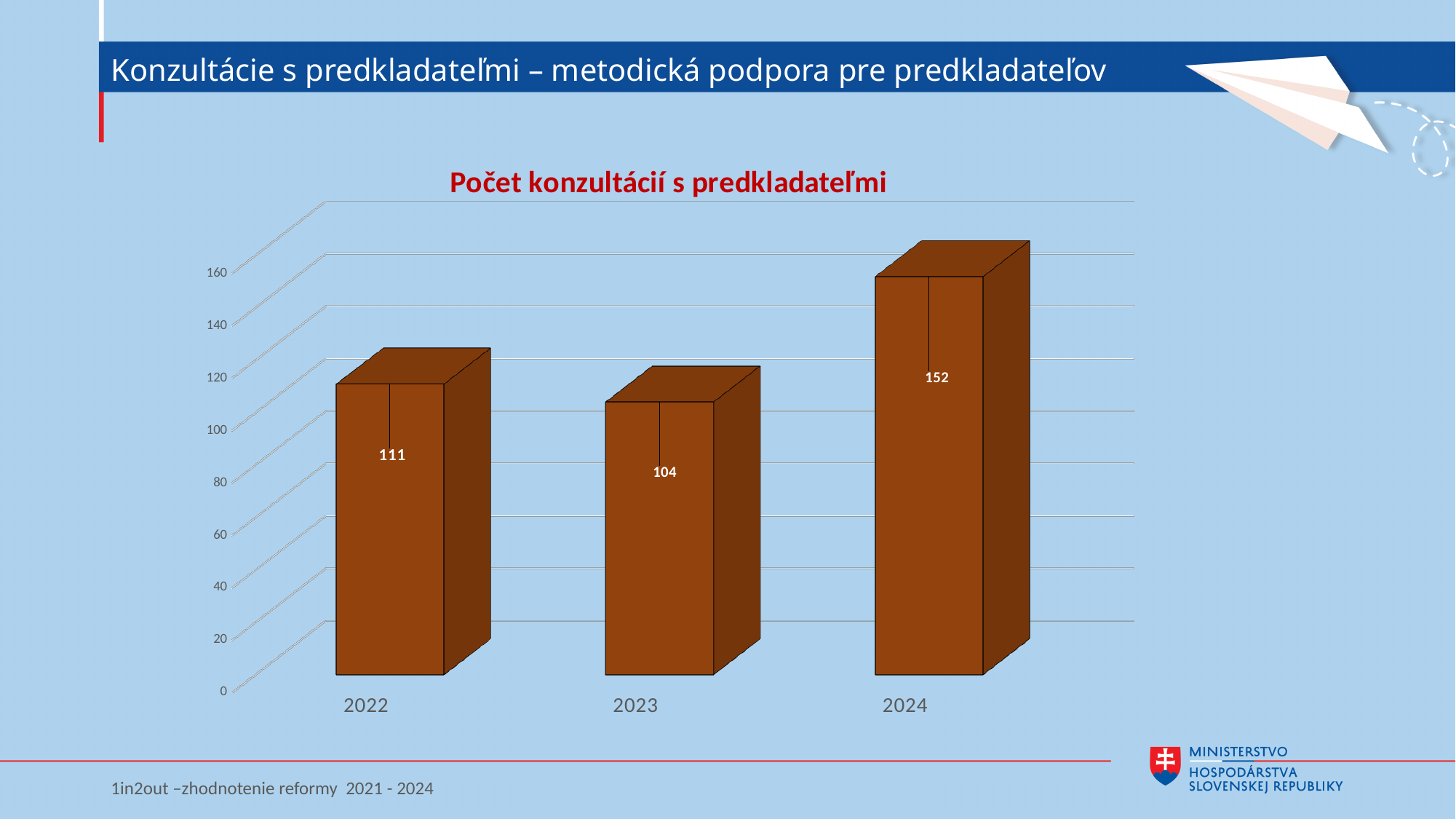
How many years are shown on the x axis? 3 What is the difference between the values for 2022 and 2023? 7 Which year has the lowest number of consultations? 2023 Which is larger, the value for 2022 or the value for 2024? 2024 What is the difference between the values for 2024 and 2023? 48 What is the value for 2022? 111 What is the value for 2024? 152 Is the value for 2024 greater or less than 140? greater What kind of chart is shown on the slide? bar chart Which year has the highest number of consultations? 2024 What is the value for 2023? 104 What is the title of the chart? Počet konzultácií s predkladateľmi